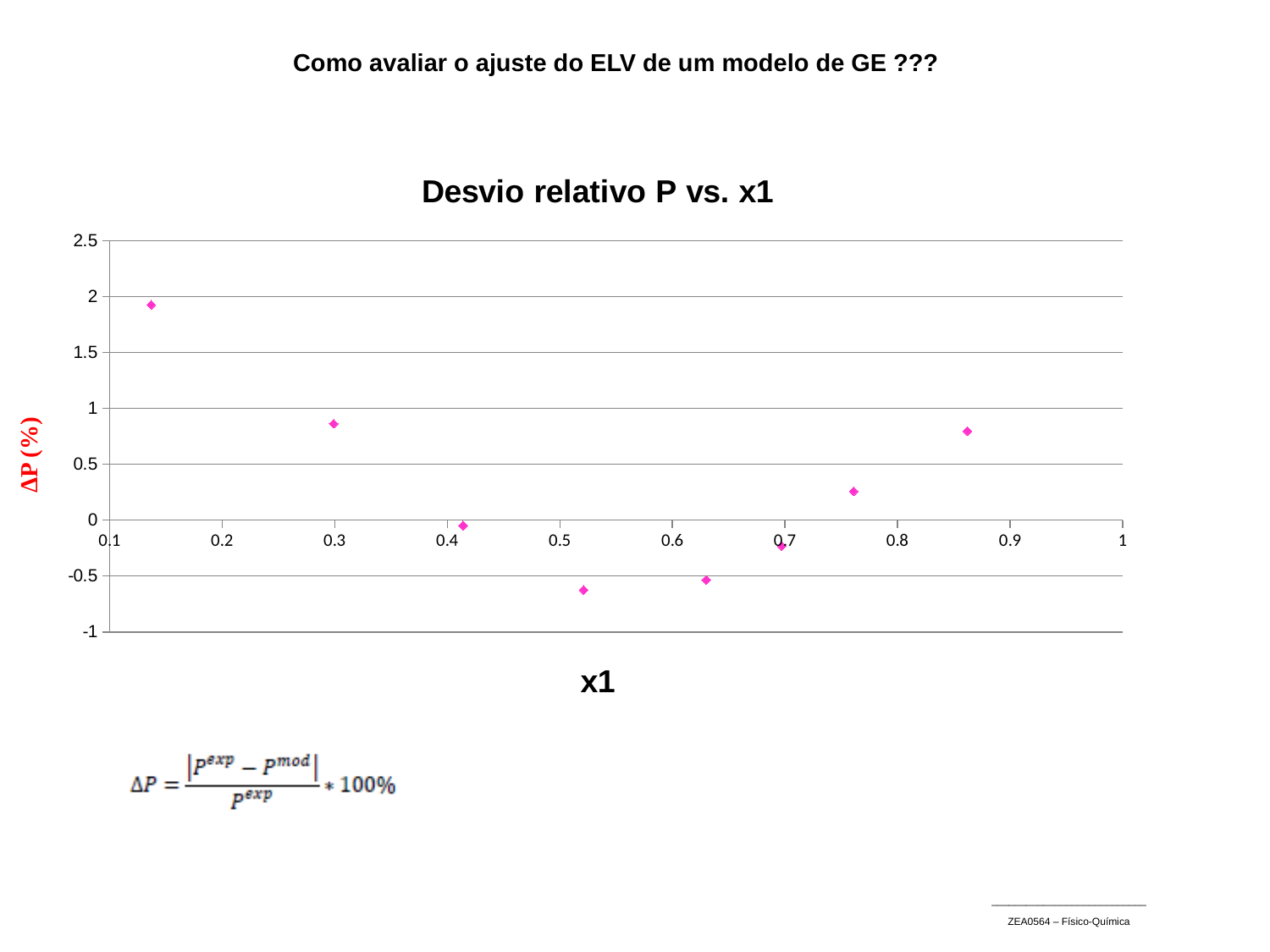
Is the value of the point near x1 = 0.52 greater or less than -0.5? less Is the value of the leftmost point (near x1 = 0.14) greater or less than 1.5? greater How many plotted points have a ΔP value greater than 1? 1 Which point has the lower ΔP value: the one near x1 = 0.52 or the one near x1 = 0.76? the one near x1 = 0.52 How many data points are plotted in the chart? 8 Is the value of the point near x1 = 0.76 greater or less than 0.5? less What is the label of the vertical axis? ΔP (%) Which point has the highest ΔP value: the one near x1 = 0.14 or the one near x1 = 0.86? the one near x1 = 0.14 What is the title of the chart? Desvio relativo P vs. x1 What kind of chart is shown on the slide? scatter chart